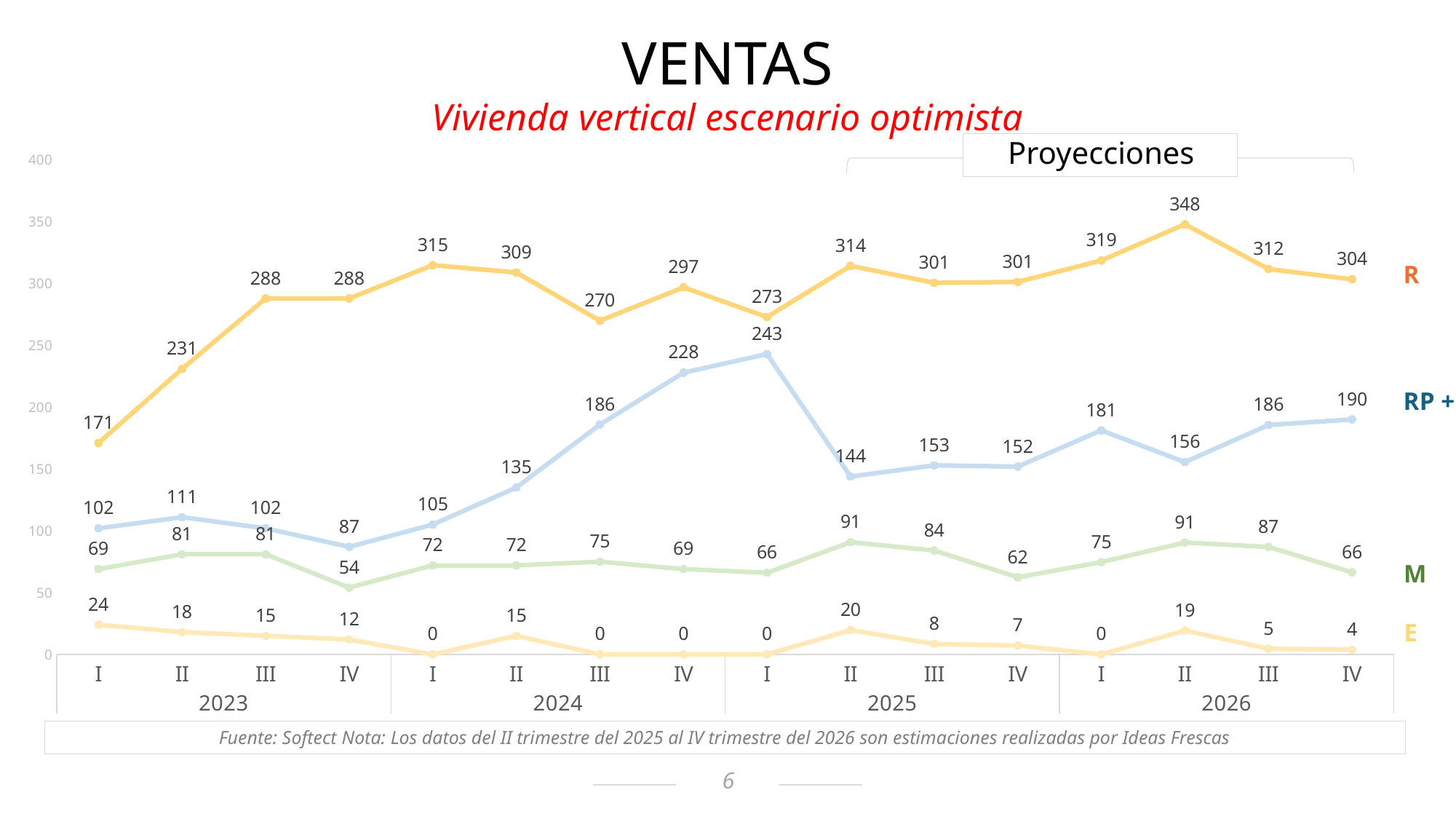
What is the red subtitle of the chart? Vivienda vertical escenario optimista Does the R series rise or fall from quarter I of 2023 to quarter I of 2024? Rises How many quarters are plotted along the x axis? 16 What is the difference between the R value in quarter II of 2026 and the R value in quarter I of 2023? 177 What is the value of the E series in quarter II of 2025? 20 In which quarter does the M series have its lowest value? IV 2023 Which is larger for the RP + series: the value in quarter IV of 2024 or the value in quarter I of 2025? I 2025 In which quarter does the R series reach its highest value? II 2026 What type of chart is shown on the slide? Line chart How many series are shown in the chart? 4 What is the value of the RP + series in quarter I of 2025? 243 What is the value of the R series in quarter II of 2026? 348